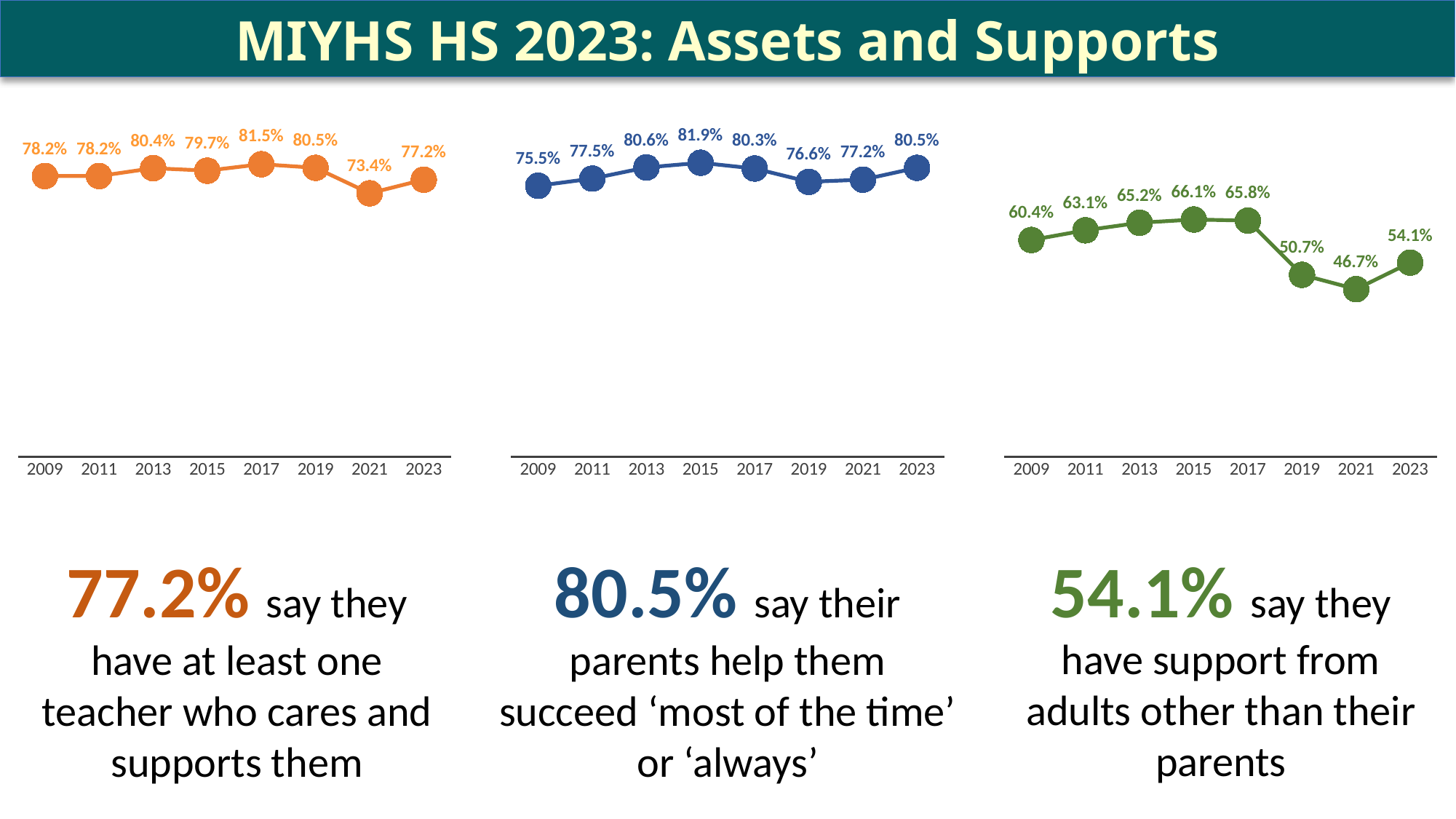
In the right (green) chart, which year has the lowest value? 2021 What kind of chart is the middle (blue) chart? line chart How many years are plotted in the right (green) chart? 8 In the right (green) chart, what is the difference between the 2017 value and the 2019 value? 15.1% In the right (green) chart, do the values rise or fall from 2017 to 2021? fall In the left (orange) chart, what is the difference between the 2023 value and the 2021 value? 3.8% In the middle (blue) chart, what is the value for 2015? 81.9% In the middle (blue) chart, which is larger, the value for 2013 or the value for 2019? 2013 In the right (green) chart, what is the value for 2023? 54.1% In the left (orange) chart, which year has the highest value? 2017 In the middle (blue) chart, which year has the lowest value? 2009 In the left (orange) chart, what is the value for 2021? 73.4%